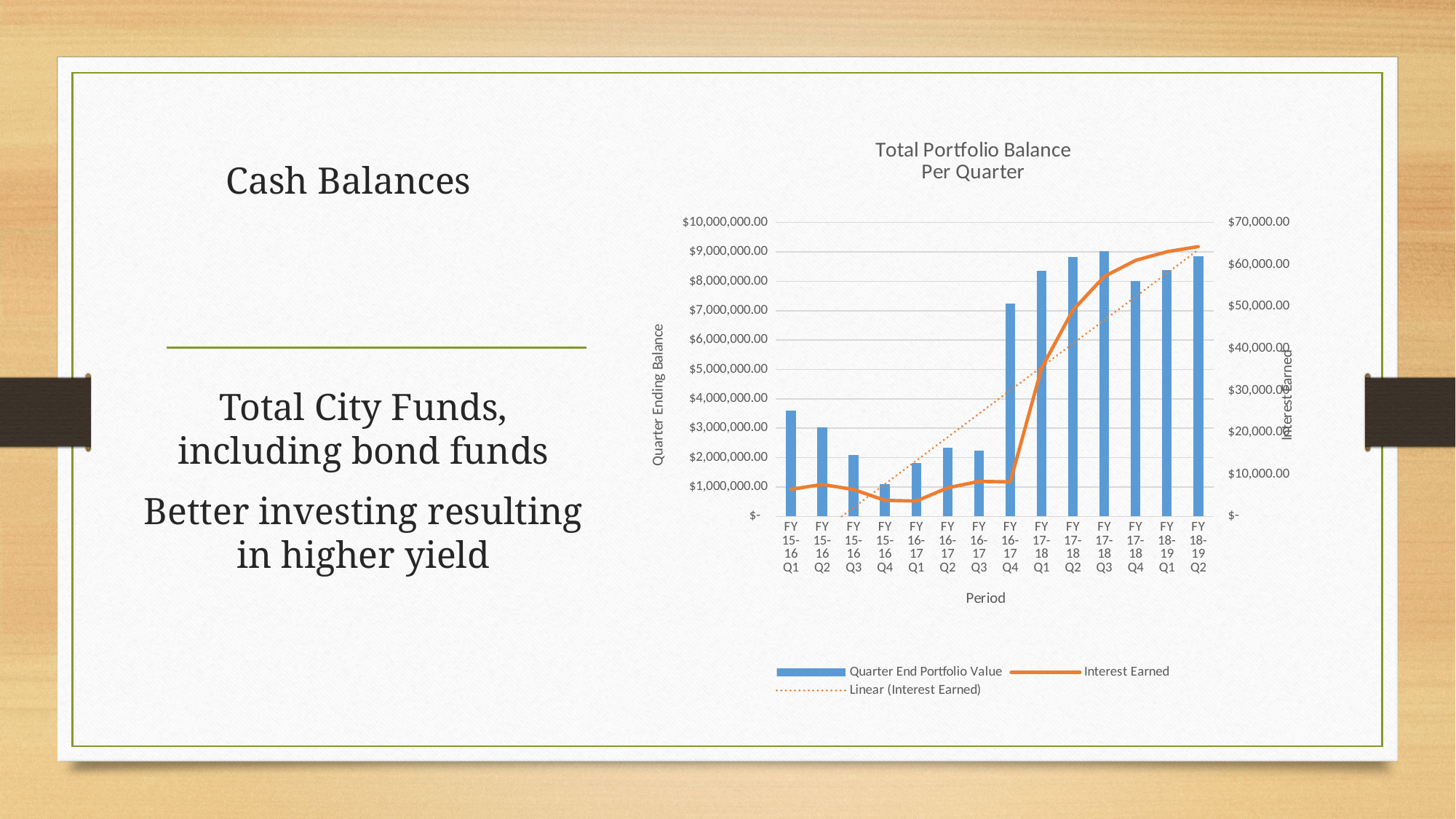
Which period has the lowest Quarter End Portfolio Value? FY 15-16 Q4 What is the title of the chart? Total Portfolio Balance Per Quarter Does the Interest Earned line generally rise or fall from FY 16-17 Q4 to FY 18-19 Q2? rise Is the Quarter End Portfolio Value for FY 15-16 Q3 greater or less than $3,000,000.00? less How many quarters (periods) are shown on the x axis? 14 Which has the larger Quarter End Portfolio Value, FY 16-17 Q3 or FY 16-17 Q4? FY 16-17 Q4 Is the Interest Earned for FY 15-16 Q1 greater or less than $10,000.00? less Is the Quarter End Portfolio Value for FY 17-18 Q1 greater or less than $8,000,000.00? greater How many series does the chart legend list? 3 What kind of chart is this? Combined bar and line chart